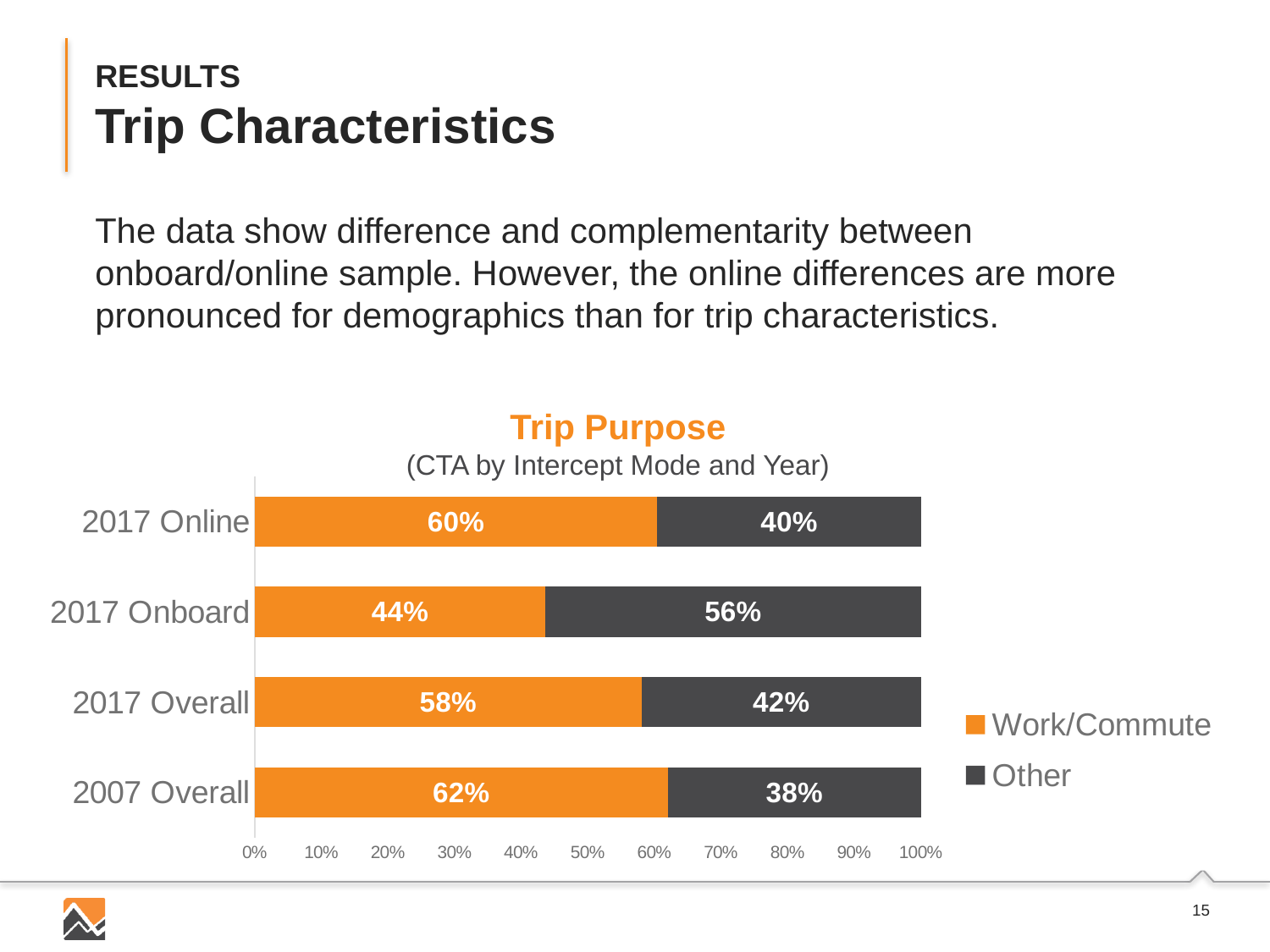
What kind of chart is shown? Stacked bar chart What is the Work/Commute value for 2017 Online? 60% What is the total of the stacked bar for 2017 Overall? 100% How many categories are shown on the y axis? 4 What is the difference between the Work/Commute values for 2017 Online and 2017 Onboard? 16% Which is larger, the Other value for 2017 Overall or the Other value for 2007 Overall? 2017 Overall How many series does the legend list? 2 What is the Work/Commute value for 2007 Overall? 62% Which category has the highest Work/Commute share? 2007 Overall What is the subtitle shown under the chart title 'Trip Purpose'? (CTA by Intercept Mode and Year) Which category has the lowest Work/Commute share? 2017 Onboard What is the Other value for 2017 Onboard? 56%